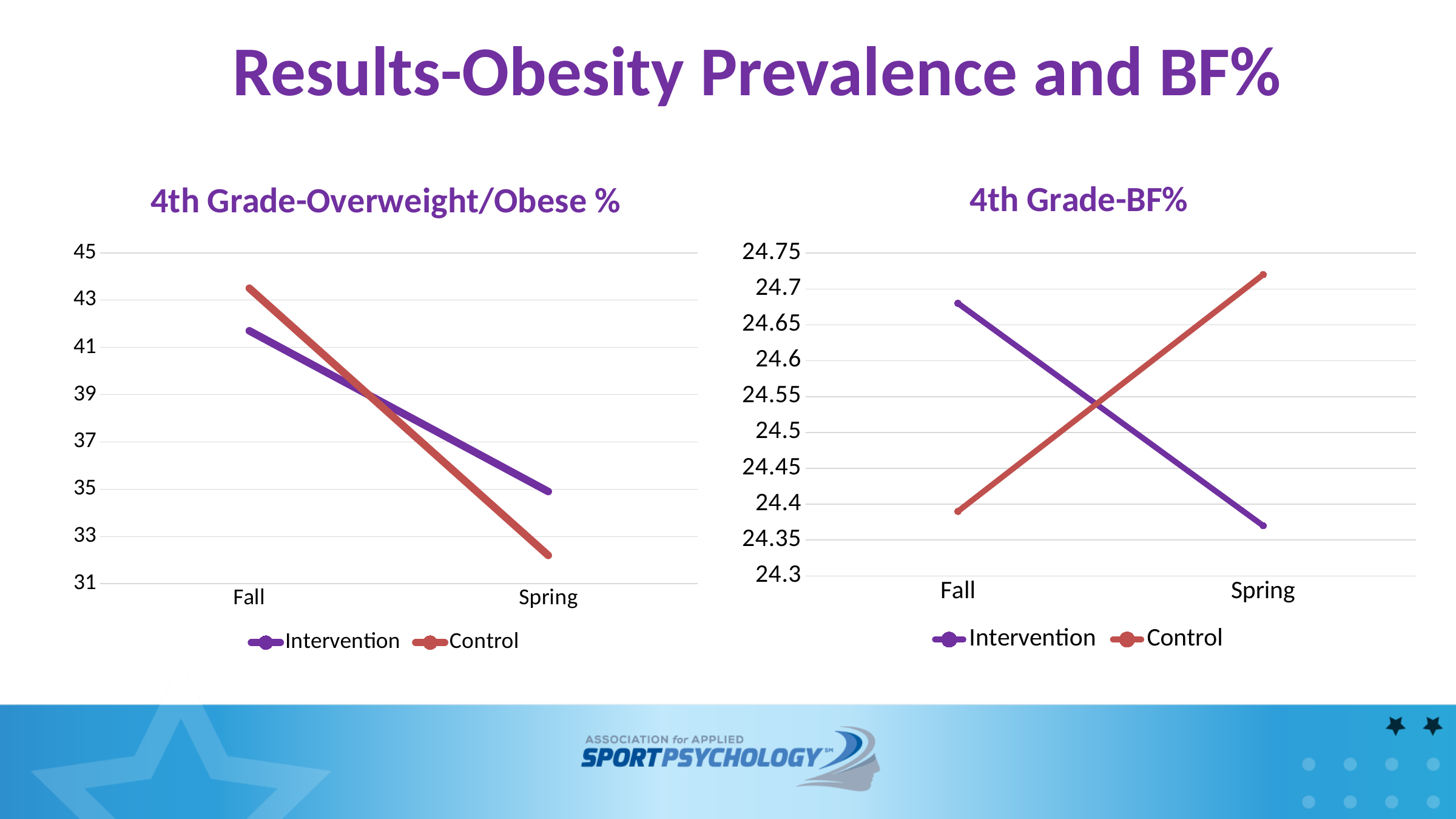
In the "4th Grade-BF%" chart, does the Control line rise or fall from Fall to Spring? rise How many categories are on the x axis of the "4th Grade-Overweight/Obese %" chart? 2 In the "4th Grade-Overweight/Obese %" chart, which series is higher at Fall, Intervention or Control? Control What colour is the Intervention line in the "4th Grade-BF%" chart? purple How many series does the legend of the "4th Grade-BF%" chart list? 2 In the "4th Grade-Overweight/Obese %" chart, which series is higher at Spring, Intervention or Control? Intervention In the "4th Grade-BF%" chart, which series is higher at Spring, Intervention or Control? Control What kind of chart is the "4th Grade-Overweight/Obese %" chart? line chart In the "4th Grade-BF%" chart, does the Intervention line rise or fall from Fall to Spring? fall In the "4th Grade-Overweight/Obese %" chart, is the Control value at Spring greater or less than 33? less In the "4th Grade-BF%" chart, is the Intervention value at Fall greater or less than 24.6? greater In the "4th Grade-Overweight/Obese %" chart, does the Control line rise or fall from Fall to Spring? fall